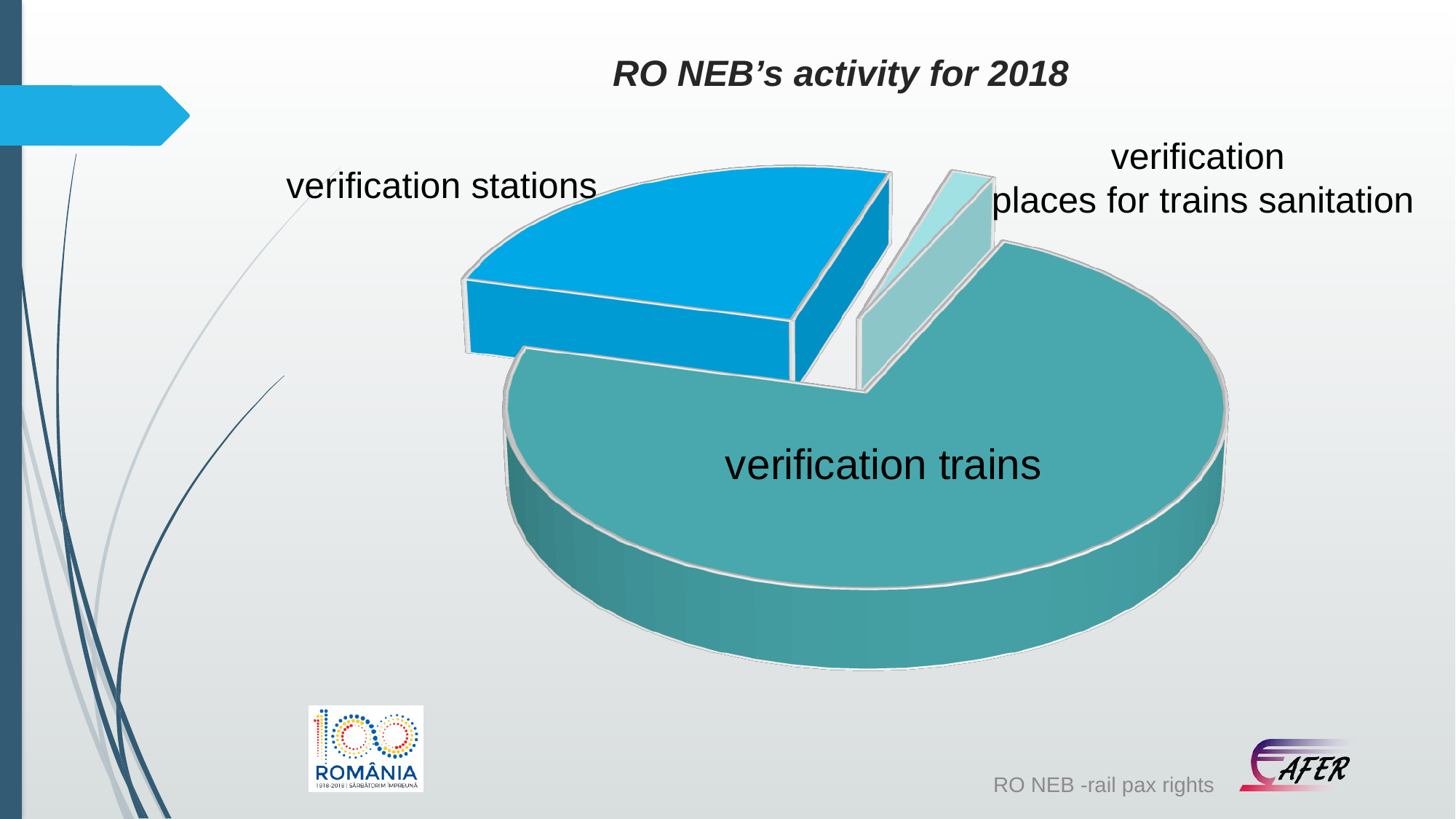
Which slice is larger: verification stations or verification places for trains sanitation? verification stations How many slices does the pie chart have? 3 Which slice is larger: verification stations or verification trains? verification trains Which category has the largest slice of the pie chart? verification trains Which category has the smallest slice of the pie chart? verification places for trains sanitation Which slice is smaller: verification trains or verification places for trains sanitation? verification places for trains sanitation What kind of chart is shown on the slide? pie chart What is the title of the chart? RO NEB's activity for 2018 Which year does the chart's title refer to? 2018